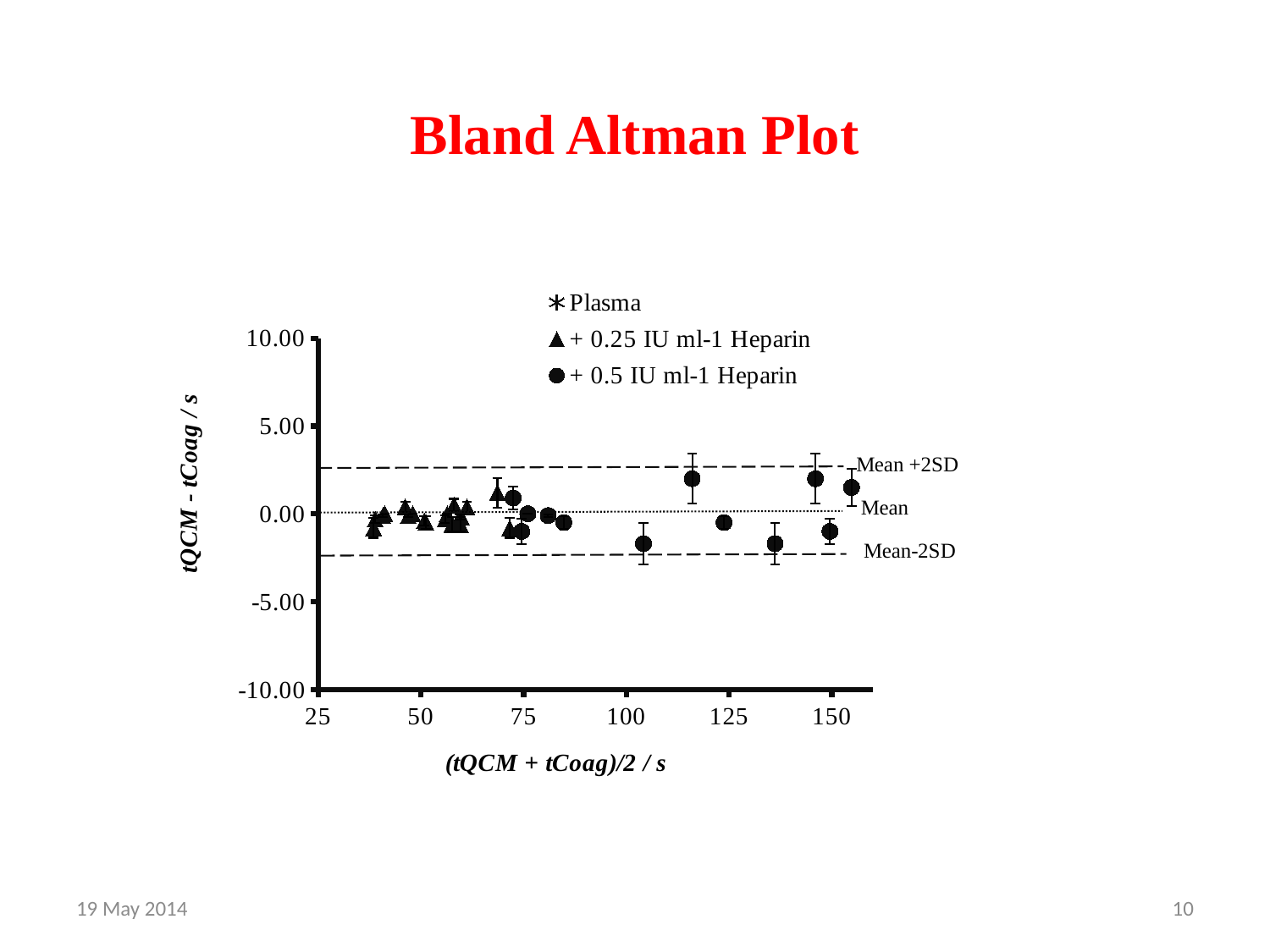
Is the Mean line greater or less than 5.00 on the y axis? less Which series is represented by circle markers in the legend? + 0.5 IU ml-1 Heparin Is the highest plotted point greater or less than 5.00 on the y axis? less Is the lowest plotted point greater or less than -5.00 on the y axis? greater What kind of chart is shown on the slide? Scatter chart How many series does the legend list? 3 What is the title of the chart? Bland Altman Plot